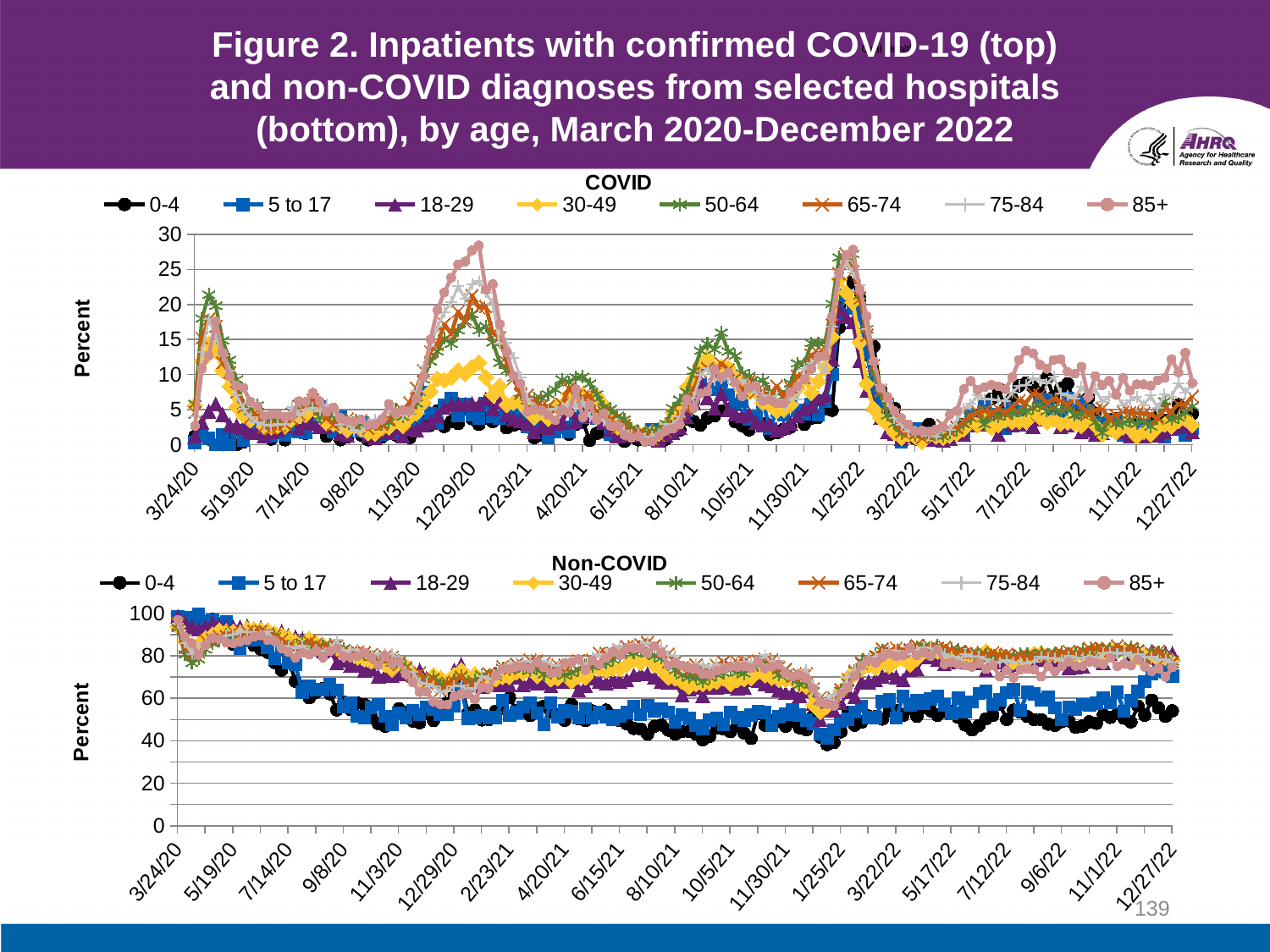
In the Non-COVID chart, around 8/10/21, which is larger: the value for 85+ or the value for 0-4? 85+ How many series does the legend of the Non-COVID chart list? 8 What kind of chart is the top chart titled COVID? line chart In the Non-COVID chart, is the value for 0-4 around 8/10/21 greater or less than 60? less In the Non-COVID chart, does the value for 0-4 rise or fall from 3/24/20 to 9/8/20? fall In the COVID chart, is the value for 0-4 around 6/15/21 greater or less than 5? less In the COVID chart, around 12/29/20, which is larger: the value for 85+ or the value for 5 to 17? 85+ In the COVID chart, is the peak value for 85+ around 12/29/20 greater or less than 25? greater What is the y-axis label on the COVID chart? Percent What is the title of the bottom chart? Non-COVID In the Non-COVID chart, which series is lowest around 8/10/21? 0-4